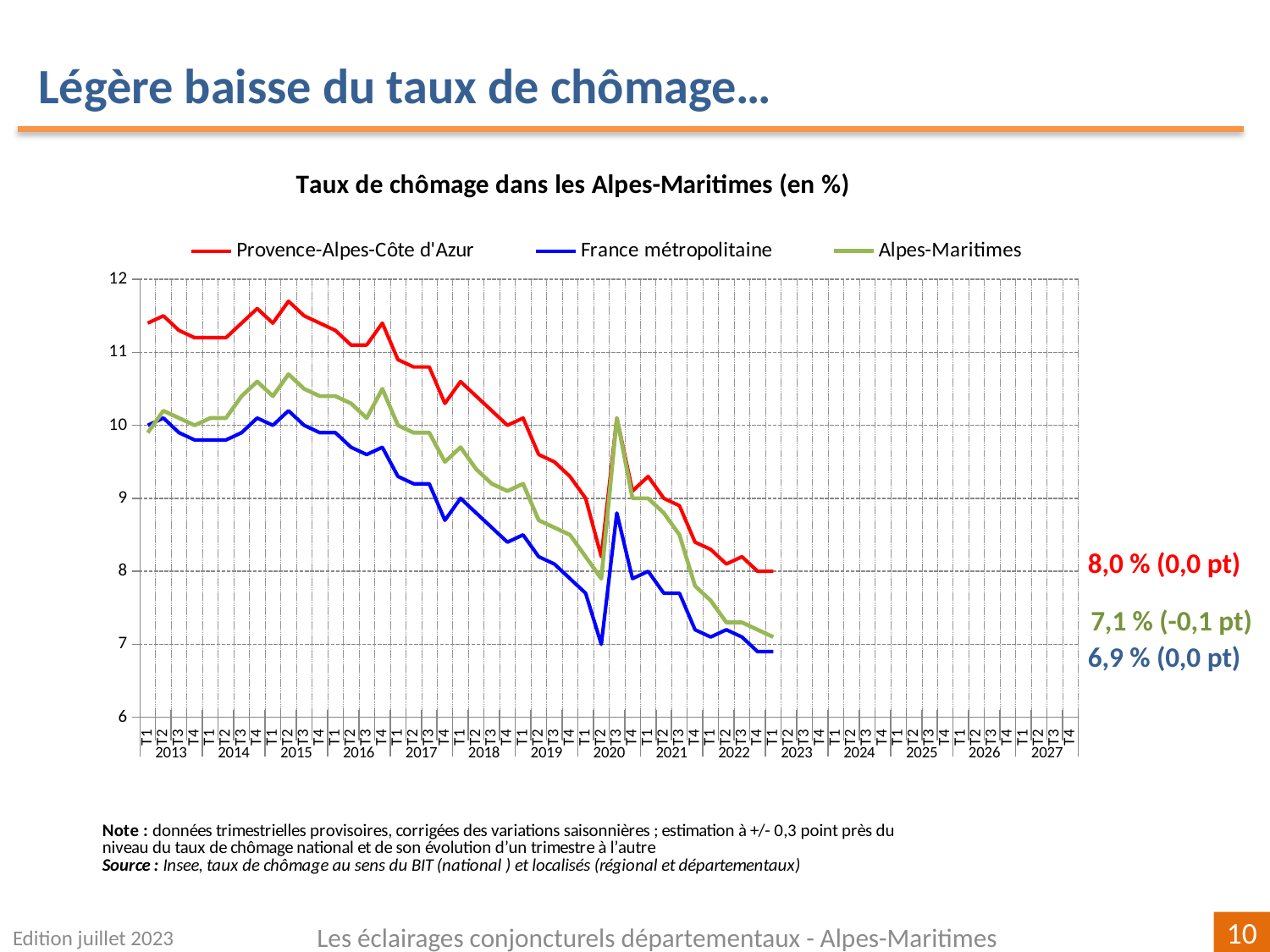
Which series has the highest latest value? Provence-Alpes-Côte d'Azur Overall, do the unemployment rates rise or fall from 2013 to 2023? fall What is the difference between the latest values for Provence-Alpes-Côte d'Azur and France métropolitaine? 1,1 points How many series does the legend list? 3 What is the latest unemployment rate shown for France métropolitaine? 6,9 % Which series is drawn in green? Alpes-Maritimes Is the value for Provence-Alpes-Côte d'Azur in T2 2015 greater or less than 11? greater What is the title of the chart? Taux de chômage dans les Alpes-Maritimes (en %) What quarterly change is indicated next to the latest Alpes-Maritimes value? -0,1 pt What is the latest unemployment rate shown for Provence-Alpes-Côte d'Azur? 8,0 % What kind of chart is shown on the slide? Line chart What is the latest unemployment rate shown for Alpes-Maritimes? 7,1 %